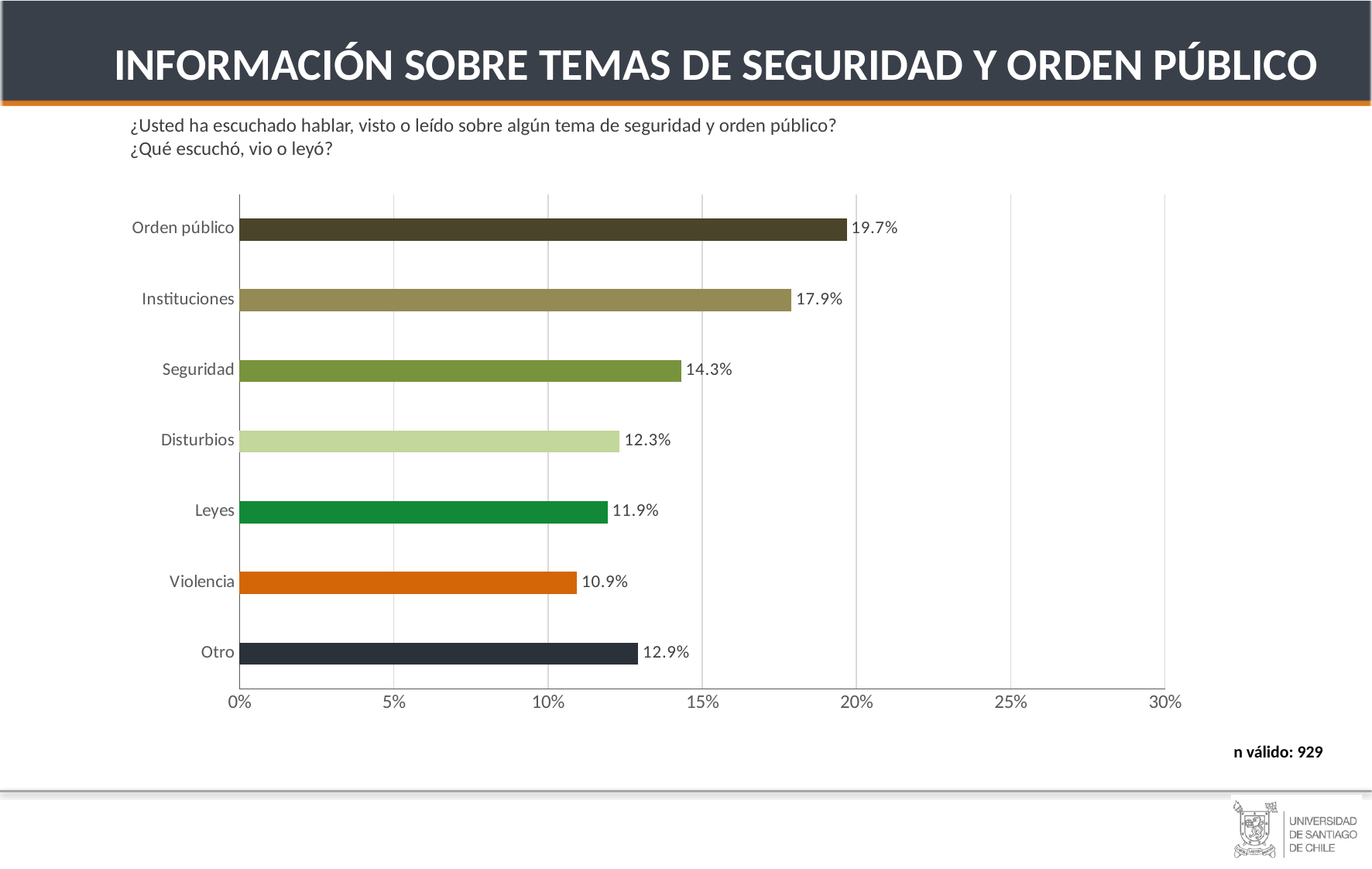
How many categories are shown in the chart? 7 Which category has the lowest value? Violencia Is the value for Seguridad greater or less than 15%? less What is the value for Otro? 12.9% What is the value for Orden público? 19.7% What is the value for Instituciones? 17.9% What is the value for Violencia? 10.9% Which is larger, the value for Leyes or the value for Otro? Otro What is the difference between the values for Orden público and Instituciones? 1.8% What kind of chart is shown on the slide? Bar chart Which category has the highest value? Orden público What is the difference between the values for Seguridad and Disturbios? 2.0%